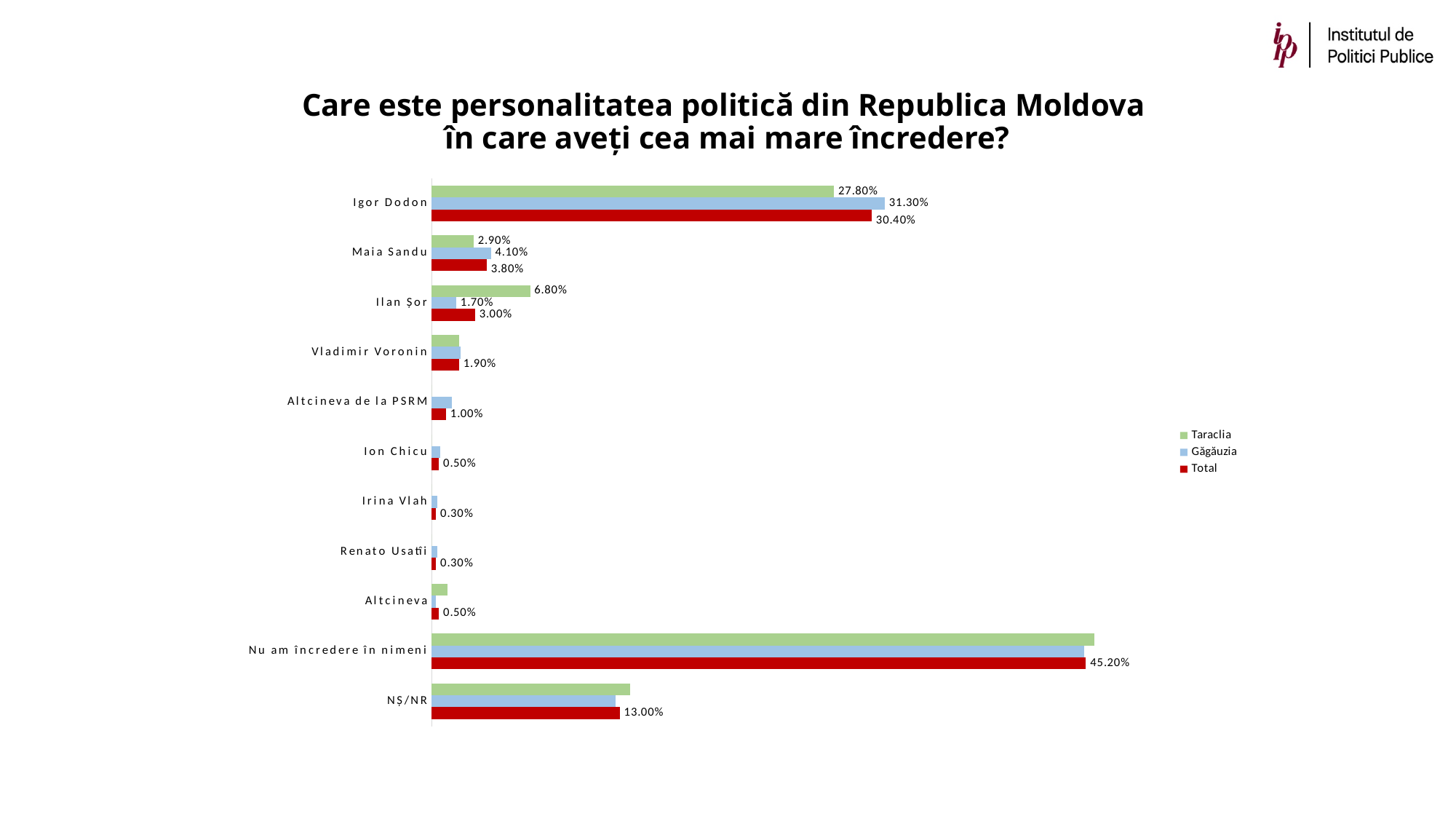
How many series does the legend list? 3 What is the Găgăuzia value for Igor Dodon? 31.30% What is the difference between the Găgăuzia and Taraclia values for Igor Dodon? 3.50% What is the Total value for 'Nu am încredere în nimeni'? 45.20% How many categories are shown on the chart? 11 Which series is shown in red in the legend? Total What is the Total value for NȘ/NR? 13.00% What is the Total value for Igor Dodon? 30.40% What is the Taraclia value for Ilan Șor? 6.80% What type of chart is shown on the slide? bar chart For Ilan Șor, which is larger: the Taraclia value or the Găgăuzia value? Taraclia Which category has the highest Total value? Nu am încredere în nimeni